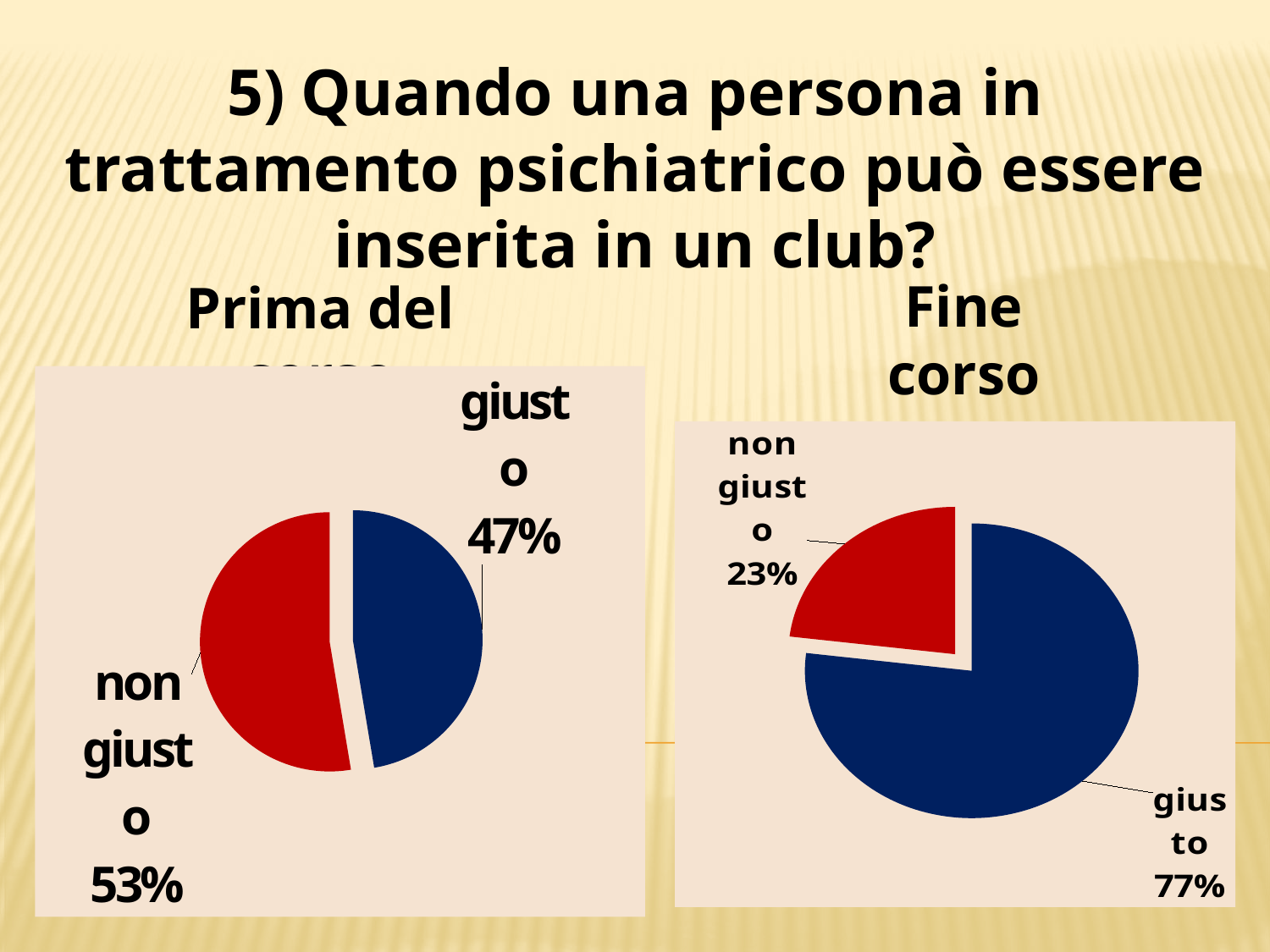
In the 'Prima del corso' pie chart, what percentage is labelled 'non giusto'? 53% In the 'Prima del corso' pie chart, what percentage is labelled 'giusto'? 47% In the 'Fine corso' pie chart, what colour is the 'non giusto' slice? Red In the 'Fine corso' pie chart, which slice is the largest? giusto In the 'Fine corso' pie chart, what is the difference between the 'giusto' and 'non giusto' shares? 54% In the 'Fine corso' pie chart, what percentage is labelled 'non giusto'? 23% In the 'Fine corso' pie chart, what percentage is labelled 'giusto'? 77% In the 'Prima del corso' pie chart, what is the difference between the 'non giusto' and 'giusto' shares? 6% What type of chart is used on the left of the slide, under 'Prima del corso'? Pie chart In the 'Prima del corso' pie chart, which slice is the smallest? giusto How many slices does the 'Fine corso' pie chart have? 2 Is the 'giusto' share larger in the 'Prima del corso' chart or in the 'Fine corso' chart? Fine corso